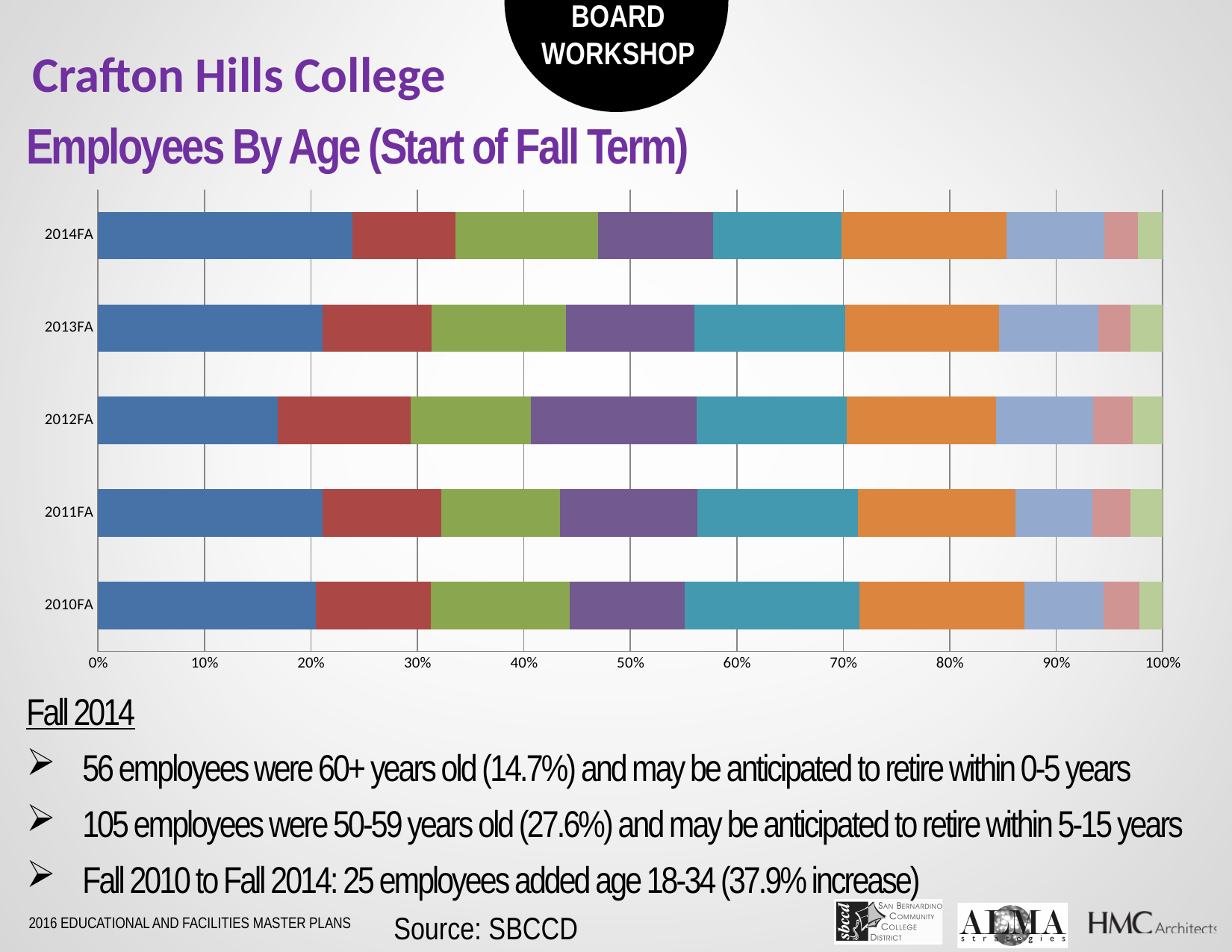
Is the first (dark blue) segment of the 2012FA bar greater or less than 20%? less Which fall term appears at the bottom of the chart? 2010FA Which fall term has the longest first (dark blue) segment? 2014FA What is the highest value shown on the horizontal axis of the chart? 100% What is the title of the chart on the slide? Employees By Age (Start of Fall Term) How many fall terms (categories) are plotted on the chart? 5 Is the first (dark blue) segment of the 2014FA bar greater or less than 20%? greater How many coloured segments make up each bar in the chart? 9 What kind of chart is shown on the slide? Stacked bar chart Is the first (dark blue) segment larger for 2014FA or for 2012FA? 2014FA Which fall term has the shortest first (dark blue) segment? 2012FA